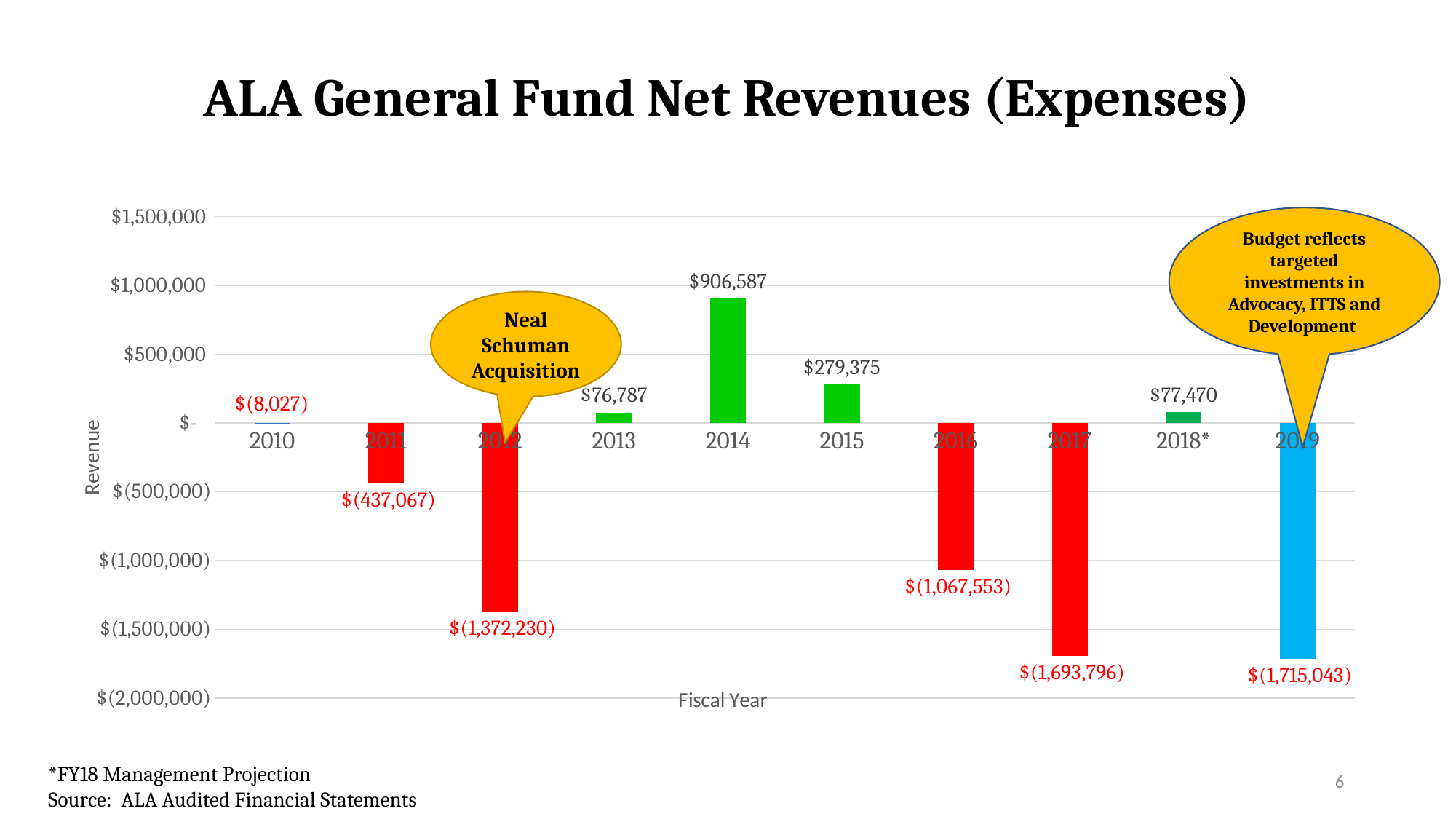
What is the net revenue value shown for fiscal year 2014? $906,587 Which is larger, the value for 2013 or the value for 2018*? 2018* How many fiscal years are plotted on the chart? 10 What event does the callout over the 2012 bar attribute the result to? Neal Schuman Acquisition Which fiscal year has the lowest value (largest net expense)? 2019 What type of chart is shown on the slide? Bar chart What is the difference between the 2014 value and the 2015 value? $627,212 Do the values rise or fall from 2015 to 2017? Fall Which fiscal year has the highest net revenue? 2014 What value is labeled for fiscal year 2012? $(1,372,230) What is the value shown for 2018*? $77,470 What value is labeled for fiscal year 2019? $(1,715,043)